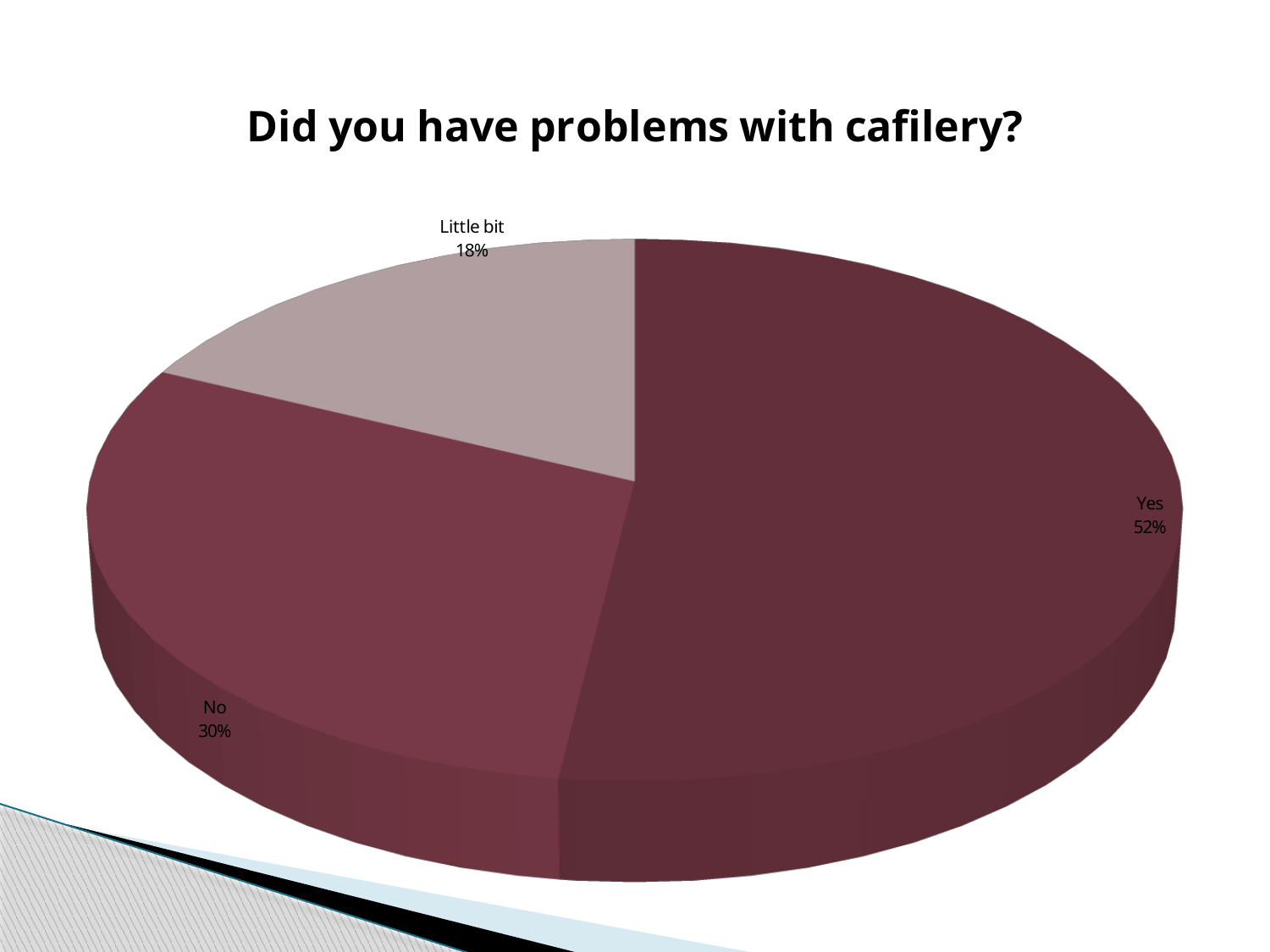
Which response has the largest share of the pie? Yes What kind of chart is shown on the slide? pie chart Which response has the smallest share of the pie? Little bit What is the difference in percentage points between the "Yes" and "No" slices? 22 How many slices does the pie chart have? 3 Which slice is larger, "No" or "Little bit"? No What is the difference in percentage points between the "No" and "Little bit" slices? 12 What percentage of respondents answered "Little bit"? 18% What percentage of respondents answered "Yes"? 52% What is the title of the chart? Did you have problems with cafilery? What percentage of respondents answered "No"? 30% Which slice is shown in the lightest colour? Little bit